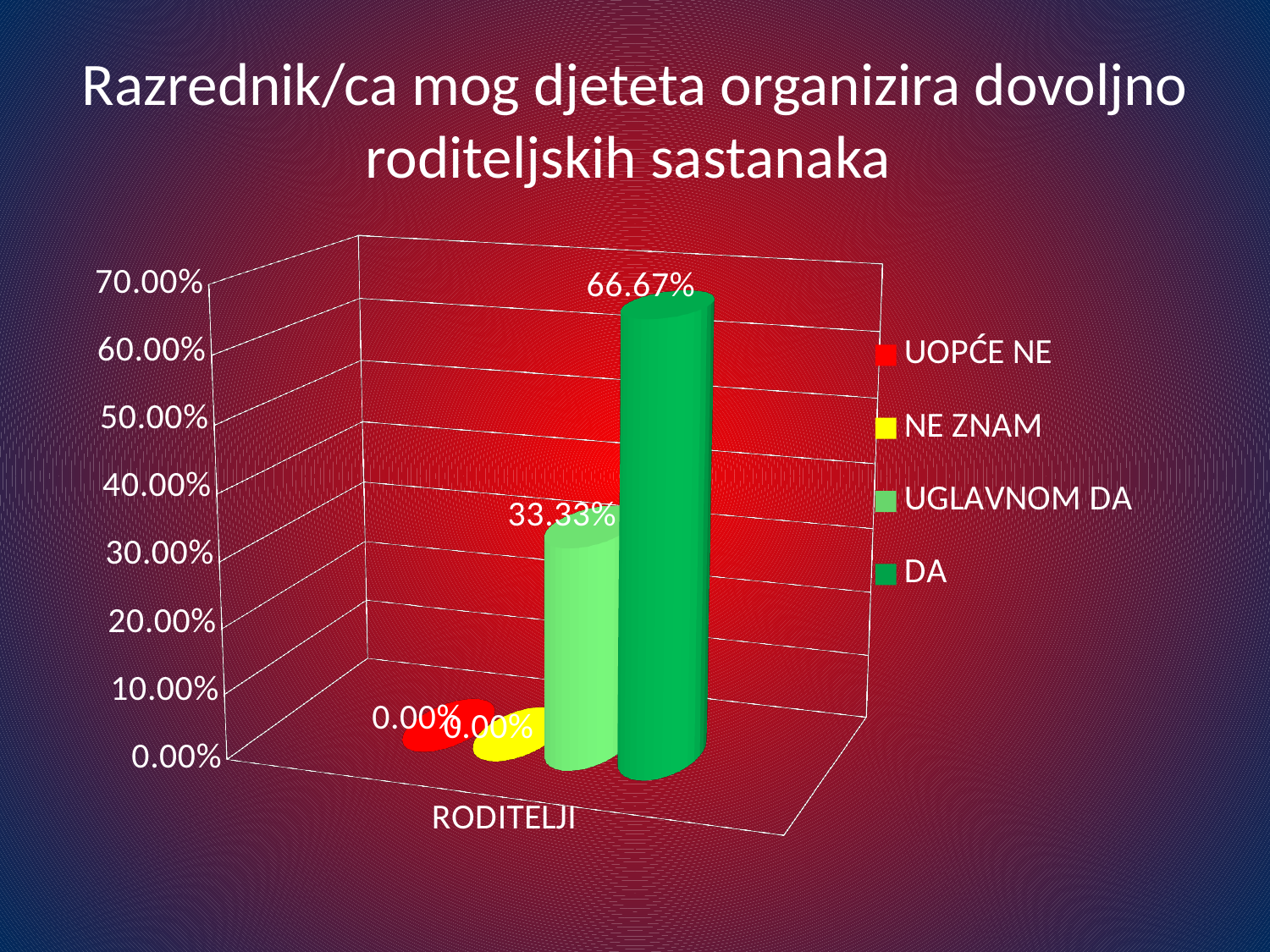
What colour represents the DA series in the legend? green Is the value for DA greater or less than 60.00%? greater What kind of chart is shown on the slide? bar chart Which series has the highest value? DA What is the value for UOPĆE NE in the RODITELJI category? 0.00% How many series does the legend list? 4 Which is larger, the value for DA or the value for UGLAVNOM DA? DA What is the value for NE ZNAM in the RODITELJI category? 0.00% What is the value for DA in the RODITELJI category? 66.67% What is the value for UGLAVNOM DA in the RODITELJI category? 33.33% What is the difference between the DA value and the UGLAVNOM DA value? 33.34% How many categories are shown on the x axis? 1